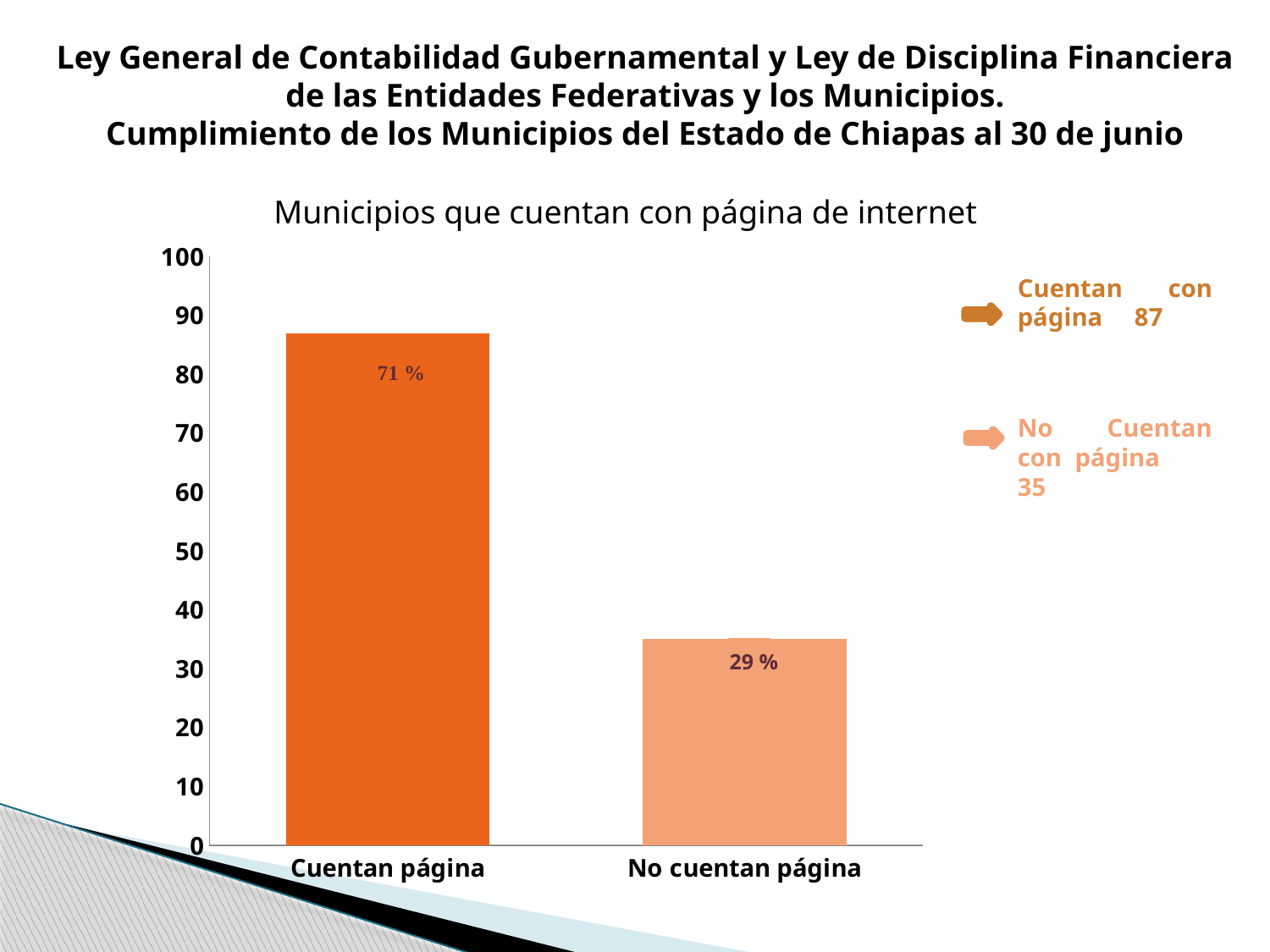
Which category has the lowest bar? No cuentan página Is the value for Cuentan página greater or less than 80? greater What percentage label is shown on the bar for Cuentan página? 71 % What is the highest value shown on the vertical axis? 100 What is the title of the chart? Municipios que cuentan con página de internet Which bar is taller, Cuentan página or No cuentan página? Cuentan página What percentage label is shown on the bar for No cuentan página? 29 % How many bars does the chart have? 2 Is the value for No cuentan página greater or less than 40? less What is the difference in percentage points between the labels for Cuentan página and No cuentan página? 42 Which category has the highest bar? Cuentan página What kind of chart is shown on the slide? bar chart